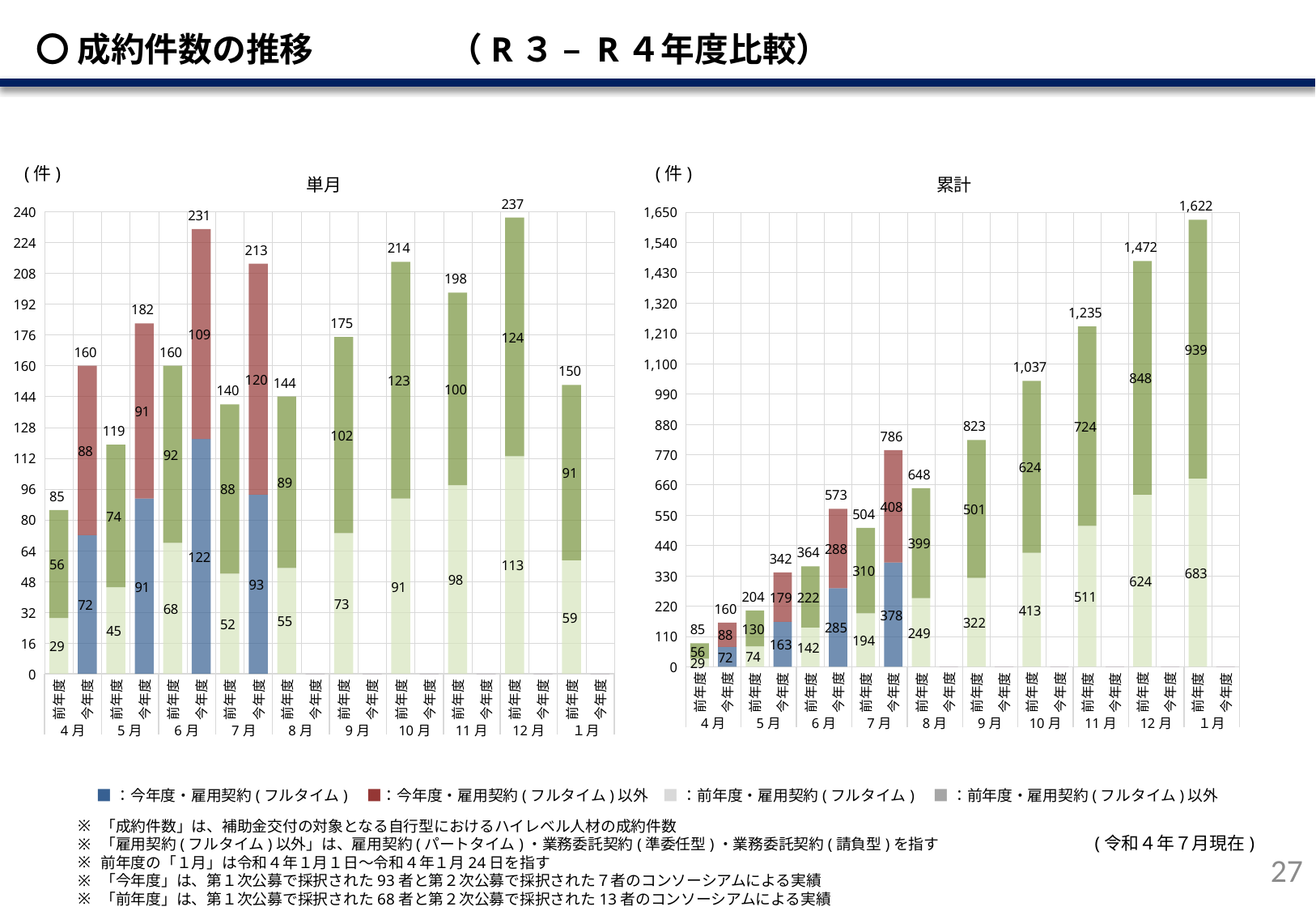
In the 単月 chart, which month has the lowest 前年度 bar total? 4月 In the 単月 chart, which is larger for 5月: the 今年度 total or the 前年度 total? 今年度 What kind of chart is the 累計 chart? stacked bar chart In the 累計 chart, do the 前年度 bar totals rise or fall from 4月 to 1月? rise In the 単月 chart, what is the total value printed above the 今年度 bar for 6月? 231 In the 単月 chart, what is the difference between the 今年度 total and the 前年度 total for 4月? 75 In the 単月 chart, what is the value of the 今年度・雇用契約(フルタイム) segment for 7月? 93 In the 累計 chart, what is the difference between the 今年度 total and the 前年度 total for 7月? 282 How many entries does the legend at the bottom of the slide list? 4 In the 累計 chart, what is the total printed above the 前年度 bar for 1月? 1,622 In the 単月 chart, which month has the highest 前年度 bar total? 12月 In the 累計 chart, what is the value of the 今年度・雇用契約(フルタイム)以外 segment for 7月? 408